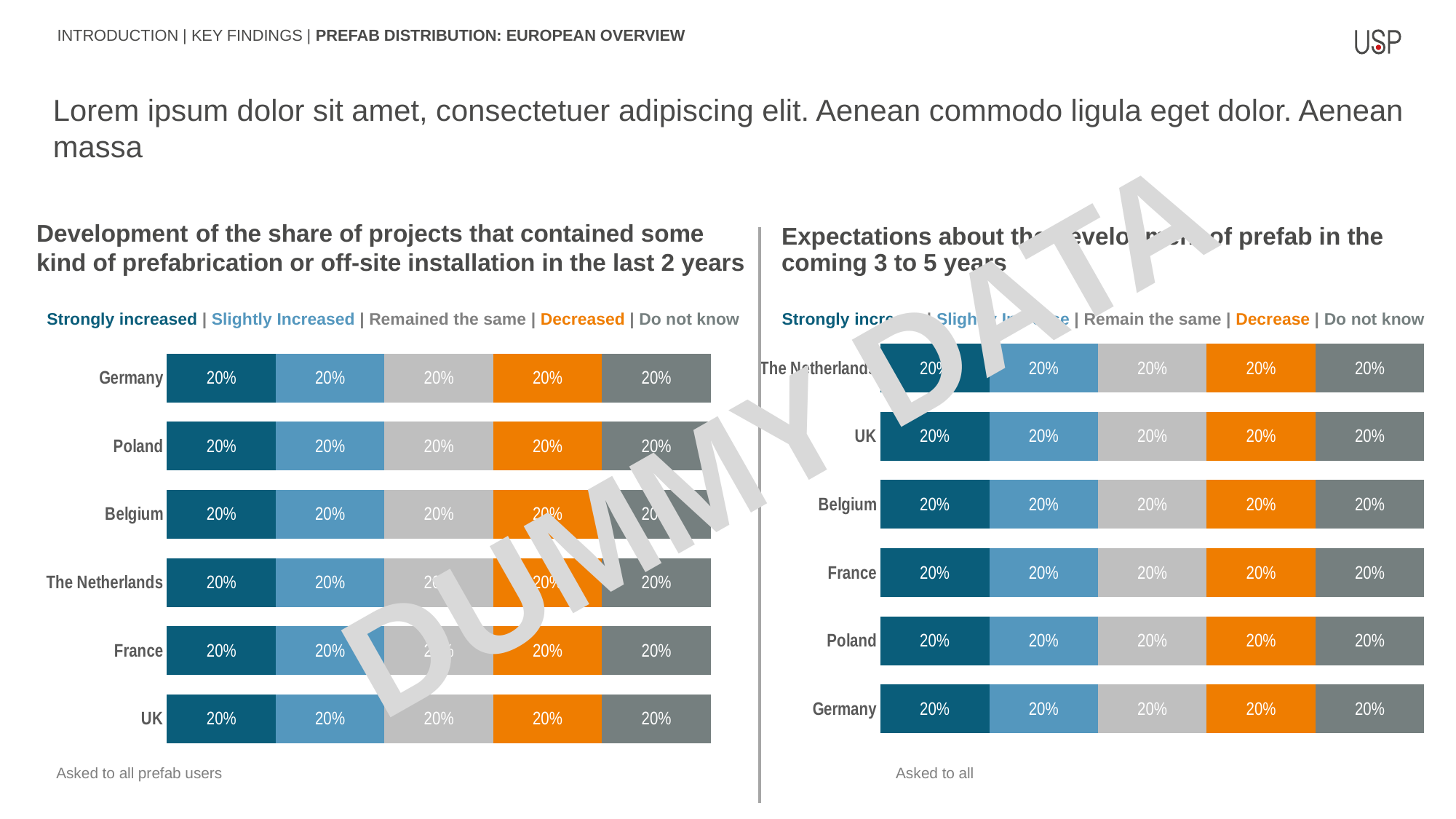
In the left chart (last 2 years), how many series does the legend list? 5 In the right chart (coming 3 to 5 years), what is the 'Slightly Increase' value for France? 20% In the right chart (coming 3 to 5 years), how many countries are shown? 6 In the left chart (last 2 years), what is the 'Decreased' value for Poland? 20% In the left chart (last 2 years), what is the 'Strongly increased' value for Germany? 20% In the left chart (last 2 years), which legend entry is shown in orange? Decreased In the right chart (coming 3 to 5 years), what is the 'Remain the same' value for Germany? 20% In the left chart (last 2 years), what is the 'Do not know' value for the UK? 20% In the right chart (coming 3 to 5 years), what is the total of the stacked bar for the UK? 100% What kind of chart is the right chart (coming 3 to 5 years)? Stacked bar chart In the left chart (last 2 years), how many countries are shown? 6 In the left chart (last 2 years), what is the total of the stacked bar for Belgium? 100%